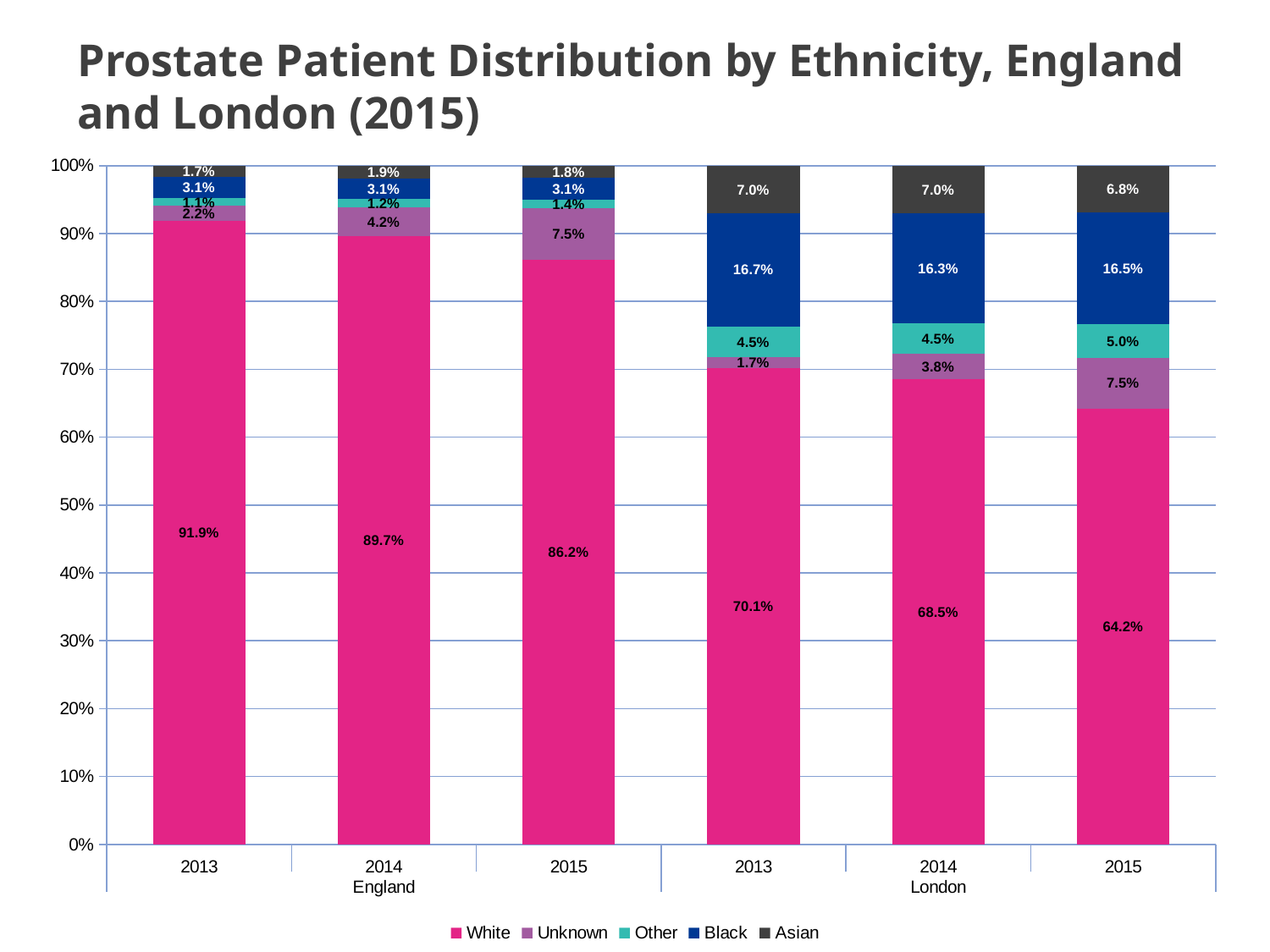
What is the Unknown share for London in 2015? 7.5% Which bar has the lowest White share? London 2015 What is the Black share for London in 2013? 16.7% What is the Asian share for London in 2015? 6.8% Which bar has the highest White share? England 2013 How many bars are plotted in the chart? 6 How many series does the legend list? 5 What is the difference between the White share for England in 2015 and London in 2015? 22.0% What is the White share for England in 2013? 91.9% What kind of chart is shown on the slide? Stacked bar chart Does the White share for England rise or fall from 2013 to 2015? Fall Is the Black share larger for London in 2013 or London in 2014? London 2013